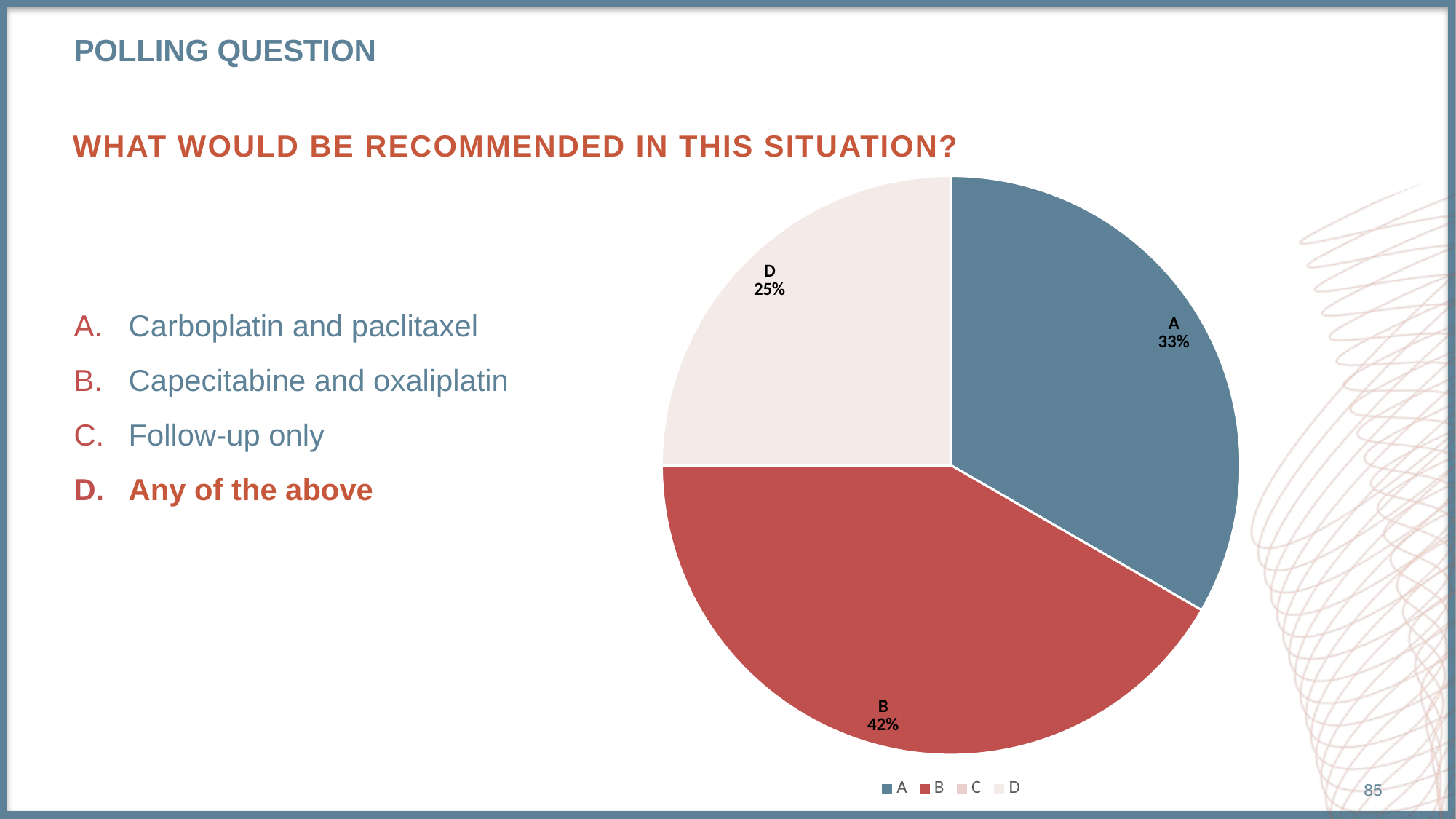
What kind of chart is shown on the slide? pie chart What percentage of the pie is labelled for option A? 33% What is the difference in percentage points between the shares for B and A? 9 Which has the larger share, A or D? A How many entries does the legend list? 4 How many slices have a percentage label printed on the pie? 3 What percentage of the pie is labelled for option B? 42% What colour is the slice for option B? red What percentage of the pie is labelled for option D? 25% Of the slices with printed labels, which option has the smallest share? D What is the difference in percentage points between the shares for A and D? 8 Which option has the largest slice of the pie? B